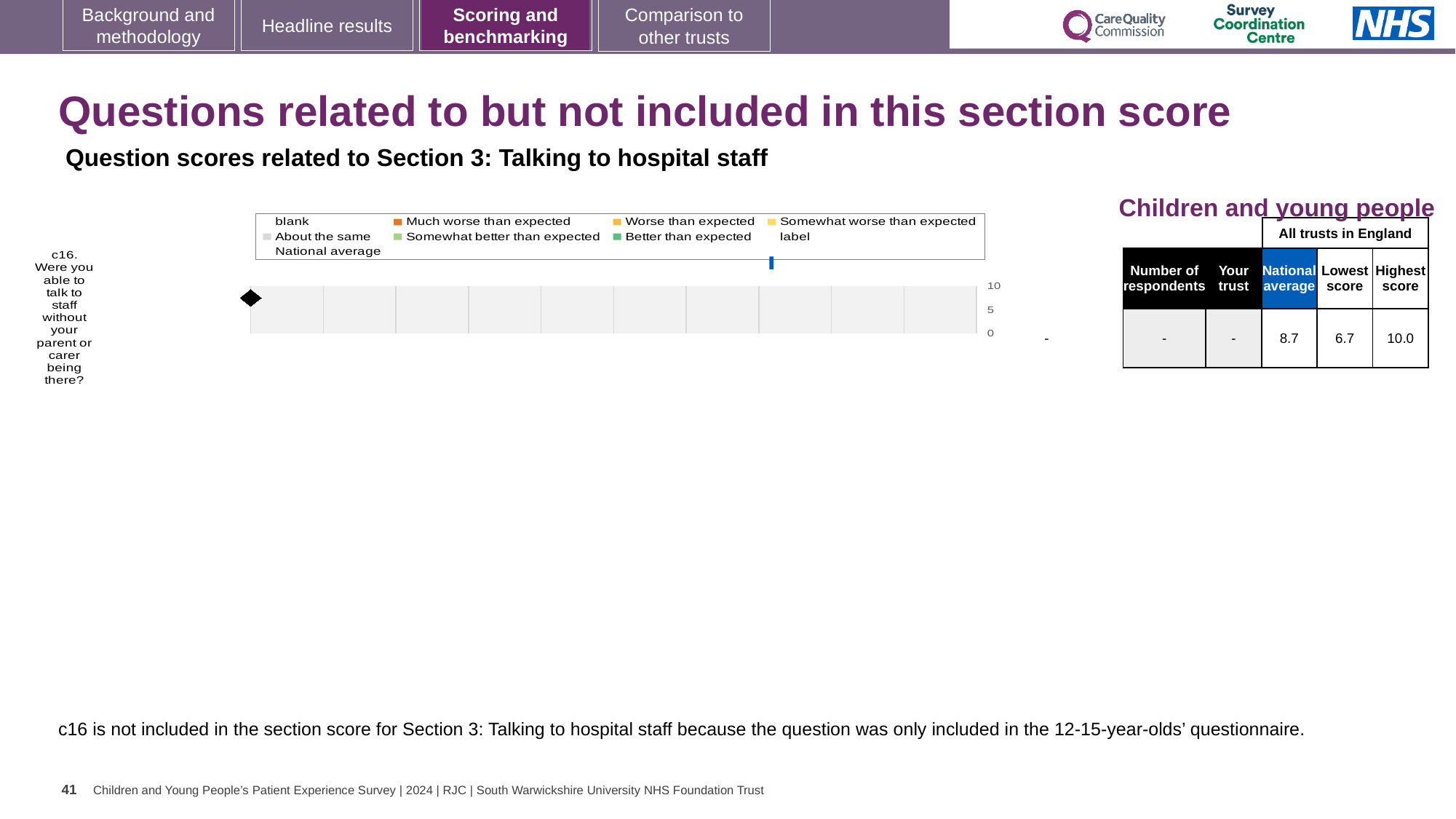
In the table, what is the national average score for c16? 8.7 In the table, what is the highest score among all trusts in England for c16? 10.0 What kind of chart is shown on the slide? bar chart In the table, what value is shown for 'Your trust' for c16? - What is the highest value shown on the chart's value axis? 10 How many survey questions are plotted on the chart? 1 In the table, what is the difference between the highest score and the lowest score for c16? 3.3 In the table, what is the lowest score among all trusts in England for c16? 6.7 Which question is shown on the chart's category axis? c16. Were you able to talk to staff without your parent or carer being there? In the table, is the national average for c16 greater or less than 5? greater